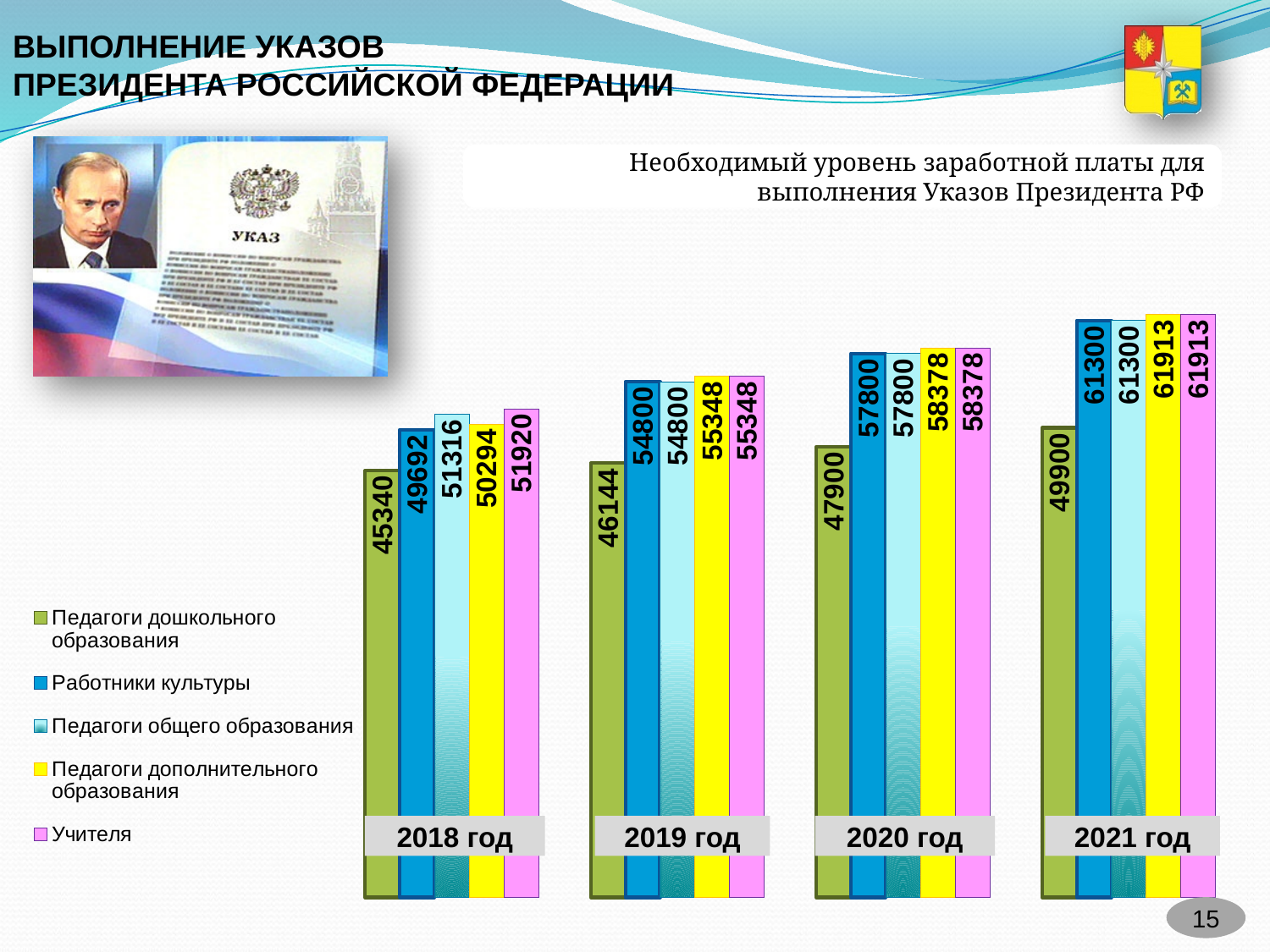
Which is larger in 2018 год: the value for Педагоги общего образования or the value for Педагоги дополнительного образования? Педагоги общего образования Do the values for Работники культуры rise or fall from 2018 год to 2021 год? rise What is the value for Педагоги дошкольного образования in 2021 год? 49900 How many series does the legend list? 5 What is the value for Учителя in 2018 год? 51920 What is the value for Педагоги дополнительного образования in 2019 год? 55348 In which year is the value for Учителя highest? 2021 год How many years are shown on the x axis of the chart? 4 What is the value for Работники культуры in 2020 год? 57800 What is the difference between the values for Учителя and Педагоги дошкольного образования in 2020 год? 10478 Which series has the lowest value in 2021 год? Педагоги дошкольного образования What kind of chart is shown on the slide? bar chart